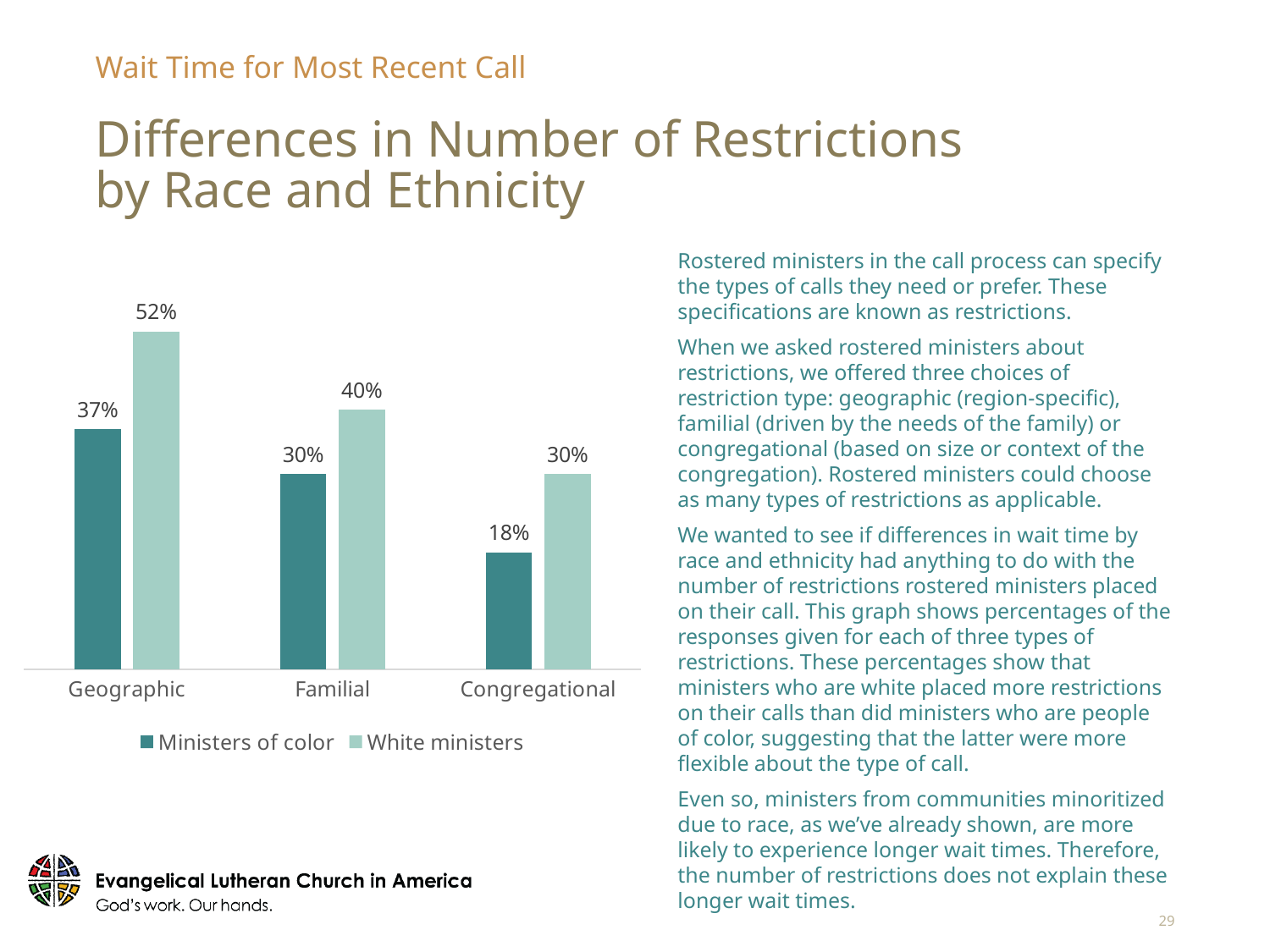
How many series does the legend list? 2 Which restriction type has the lowest value for ministers of color? Congregational Which is larger: the familial value for white ministers or the familial value for ministers of color? White ministers Do the values for ministers of color rise or fall from Geographic to Congregational? Fall What percentage of ministers of color placed a geographic restriction? 37% What is the difference between white ministers and ministers of color for the congregational restriction? 12% What percentage of ministers of color placed a congregational restriction? 18% What is the difference between white ministers and ministers of color for the geographic restriction? 15% How many restriction types are shown on the x axis? 3 What kind of chart is shown on the slide? Bar chart Which restriction type has the highest value for white ministers? Geographic What percentage of white ministers placed a familial restriction? 40%